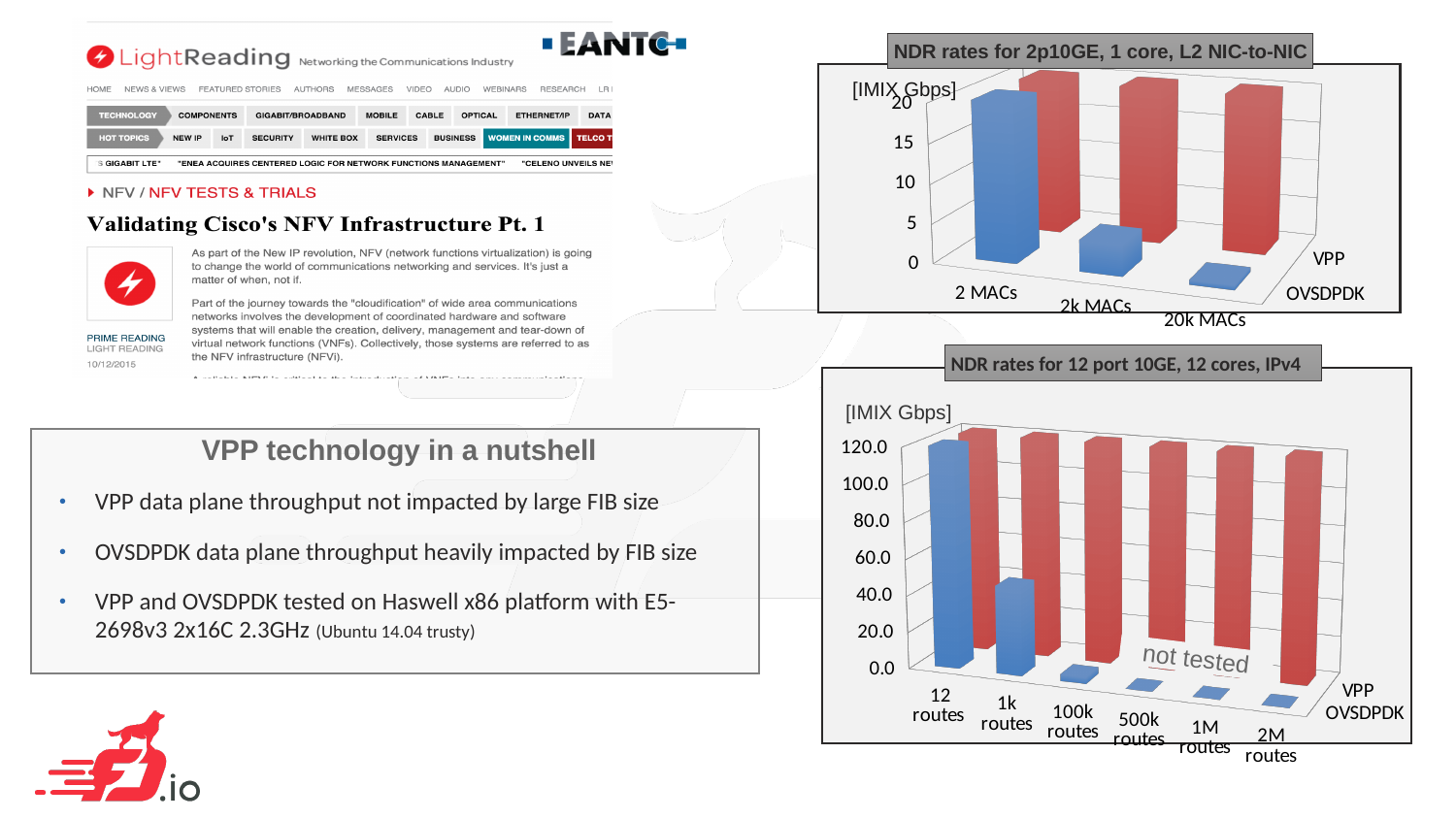
In the chart titled "NDR rates for 12 port 10GE, 12 cores, IPv4", what unit is given for the vertical axis? [IMIX Gbps] In the chart titled "NDR rates for 2p10GE, 1 core, L2 NIC-to-NIC", is the VPP value for 20k MACs greater or less than 15? greater In the chart titled "NDR rates for 2p10GE, 1 core, L2 NIC-to-NIC", how many series are shown? 2 In the chart titled "NDR rates for 2p10GE, 1 core, L2 NIC-to-NIC", do the OVSDPDK values rise or fall from 2 MACs to 20k MACs? fall What kind of chart is the chart titled "NDR rates for 12 port 10GE, 12 cores, IPv4"? bar chart In the chart titled "NDR rates for 12 port 10GE, 12 cores, IPv4", how many route-count categories are shown on the x axis? 6 In the chart titled "NDR rates for 12 port 10GE, 12 cores, IPv4", is the VPP value for 2M routes greater or less than 100.0? greater In the chart titled "NDR rates for 2p10GE, 1 core, L2 NIC-to-NIC", how many categories are shown on the x axis? 3 In the chart titled "NDR rates for 12 port 10GE, 12 cores, IPv4", is the OVSDPDK value for 1k routes greater or less than 80.0? less In the chart titled "NDR rates for 2p10GE, 1 core, L2 NIC-to-NIC", which series has the larger value for 2k MACs, VPP or OVSDPDK? VPP What kind of chart is the chart titled "NDR rates for 2p10GE, 1 core, L2 NIC-to-NIC"? bar chart